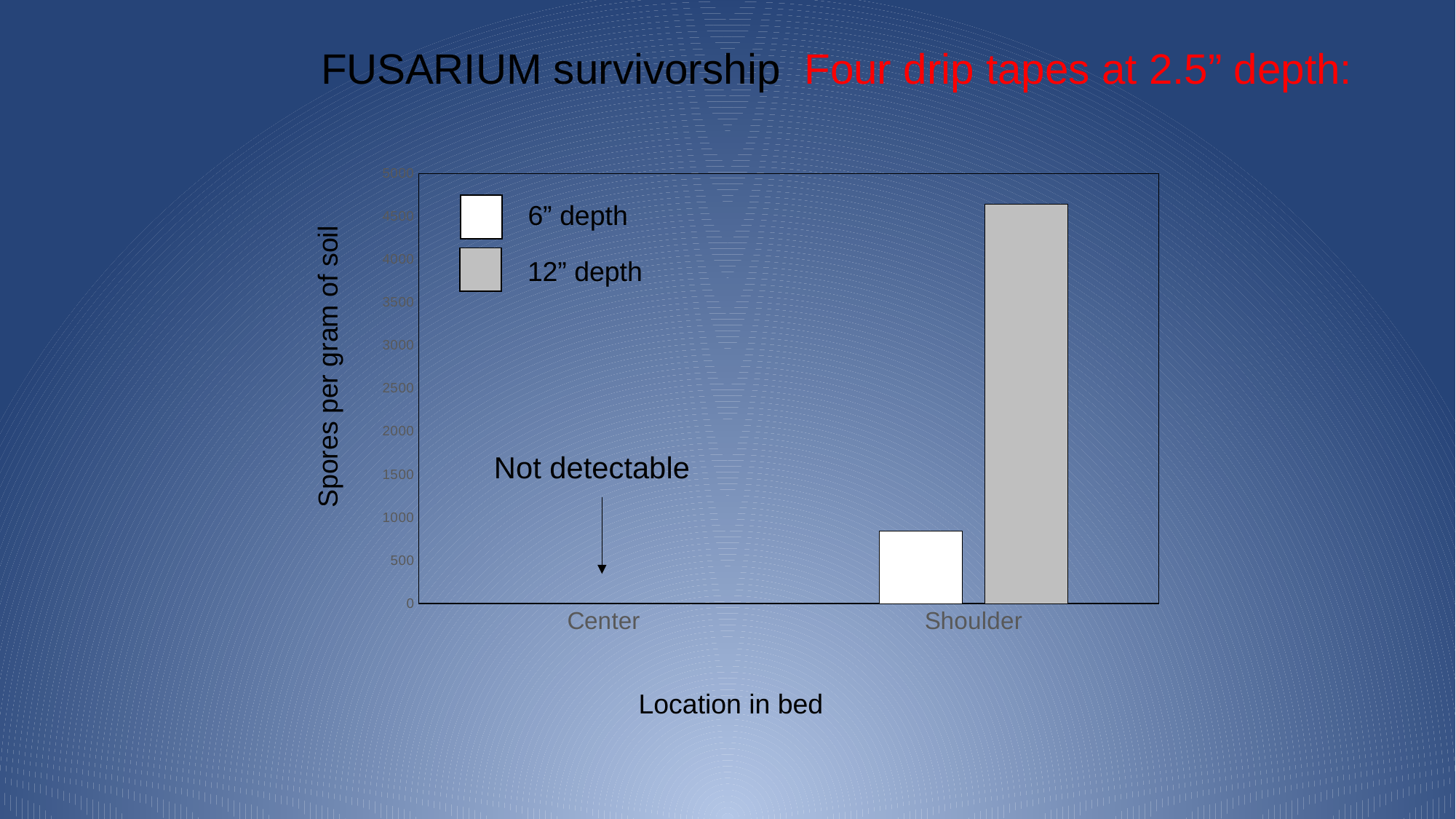
Is the value for 6" depth at the Shoulder location greater or less than 1000? less At the Shoulder location, which depth has the larger value, 6" depth or 12" depth? 12" depth Which location in bed has the highest spore count? Shoulder Which series has the tallest bar in the chart? 12" depth Which two series are listed in the legend? 6" depth and 12" depth What does the chart indicate for the Center location? Not detectable How many locations in bed are shown on the x axis? 2 How many series does the legend list? 2 Is the value for 6" depth at the Shoulder location greater or less than 500? greater What is the label of the y axis? Spores per gram of soil Is the value for 12" depth at the Shoulder location greater or less than 4000? greater What kind of chart is shown on the slide? bar chart